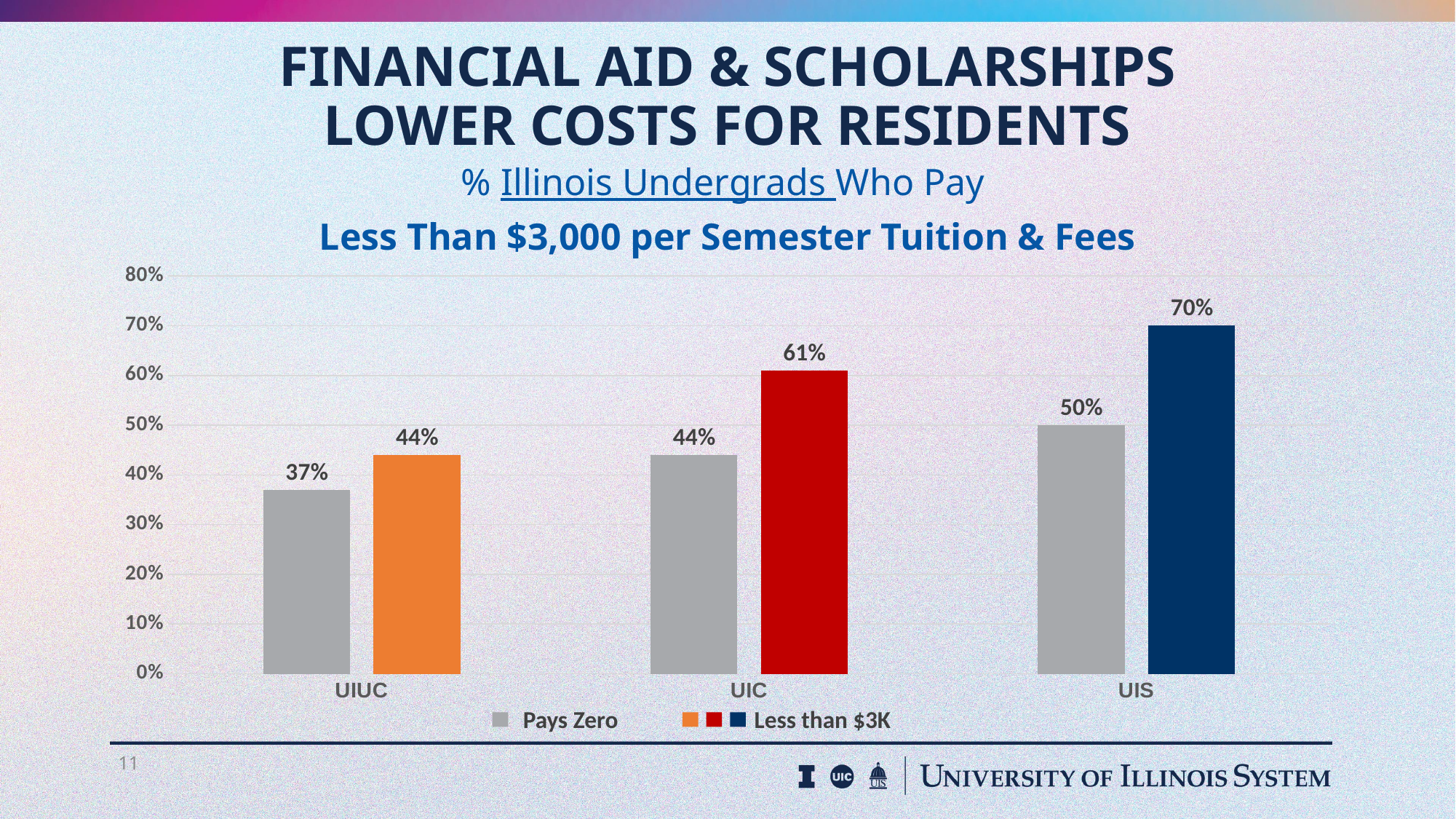
What percentage of UIC Illinois undergrads pay less than $3K per semester? 61% Which university has the lowest 'Pays Zero' percentage? UIUC How many series does the legend list? 2 What percentage of UIUC Illinois undergrads pay zero tuition and fees? 37% What is the 'Pays Zero' value for UIS? 50% Is the 'Less than $3K' value for UIC greater or less than 50%? greater What is the difference between the 'Less than $3K' values for UIS and UIUC? 26% Which is larger: the 'Pays Zero' value for UIC or the 'Less than $3K' value for UIUC? They are equal (44%) What type of chart is shown on the slide? Bar chart Which university has the highest share of Illinois undergrads paying less than $3K? UIS How many universities are shown on the x axis? 3 What is the difference between the 'Less than $3K' and 'Pays Zero' values for UIS? 20%